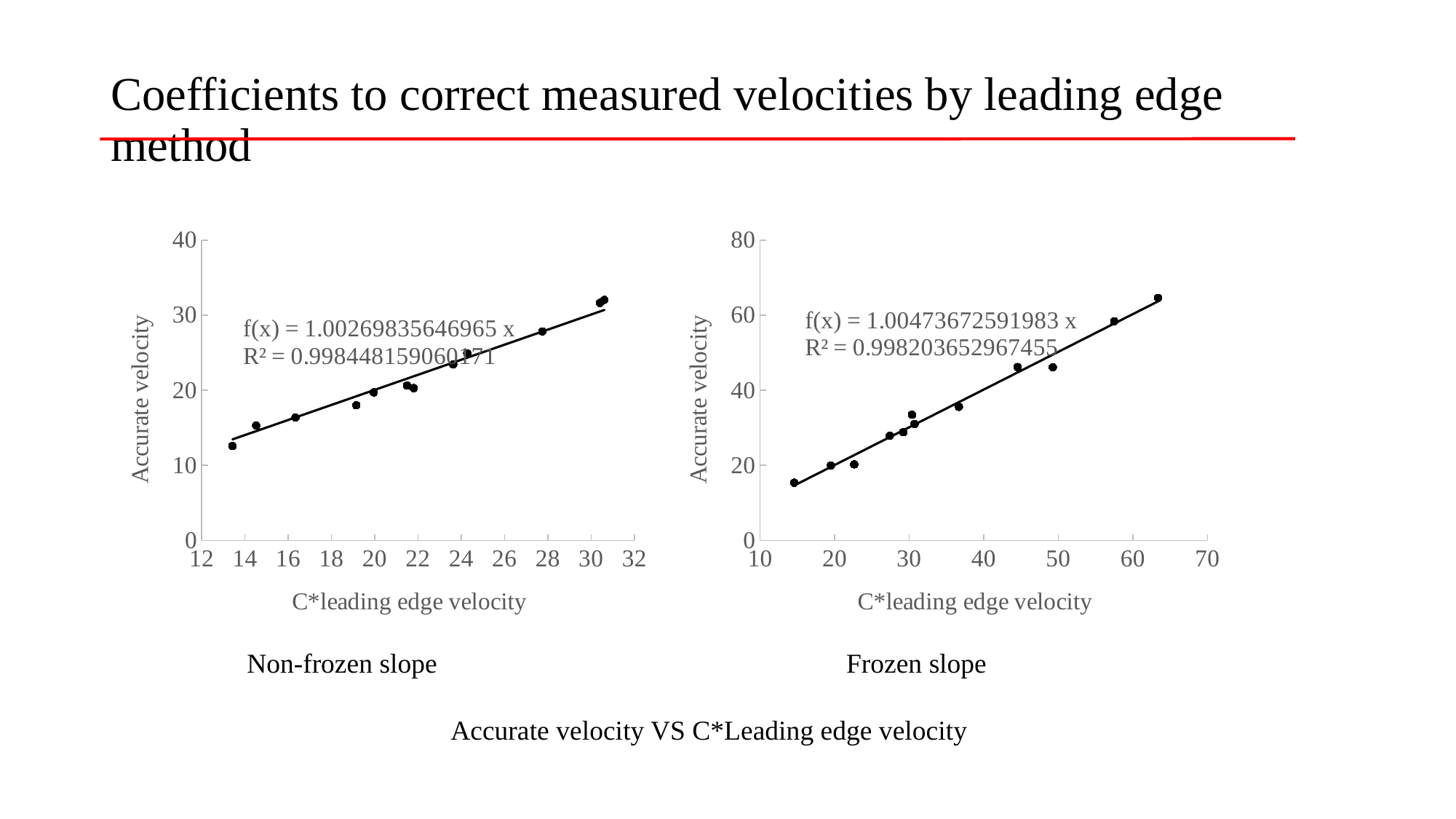
What kind of chart is the Frozen slope chart? scatter chart Which chart's fitted line has the larger slope coefficient in its displayed equation, Non-frozen slope or Frozen slope? Frozen slope In the Frozen slope chart, is the Accurate velocity of the highest point greater or less than 60? greater What kind of chart is the Non-frozen slope chart? scatter chart What is the equation of the fitted line shown on the Non-frozen slope chart? f(x) = 1.00269835646965 x What R² value is shown on the Frozen slope chart? R² = 0.998203652967455 In the Non-frozen slope chart, is the Accurate velocity of the highest point greater or less than 30? greater In the Non-frozen slope chart, do the values of Accurate velocity rise or fall as C*leading edge velocity increases? rise In the Frozen slope chart, is the Accurate velocity of the lowest point greater or less than 20? less In the Frozen slope chart, do the values of Accurate velocity rise or fall as C*leading edge velocity increases? rise